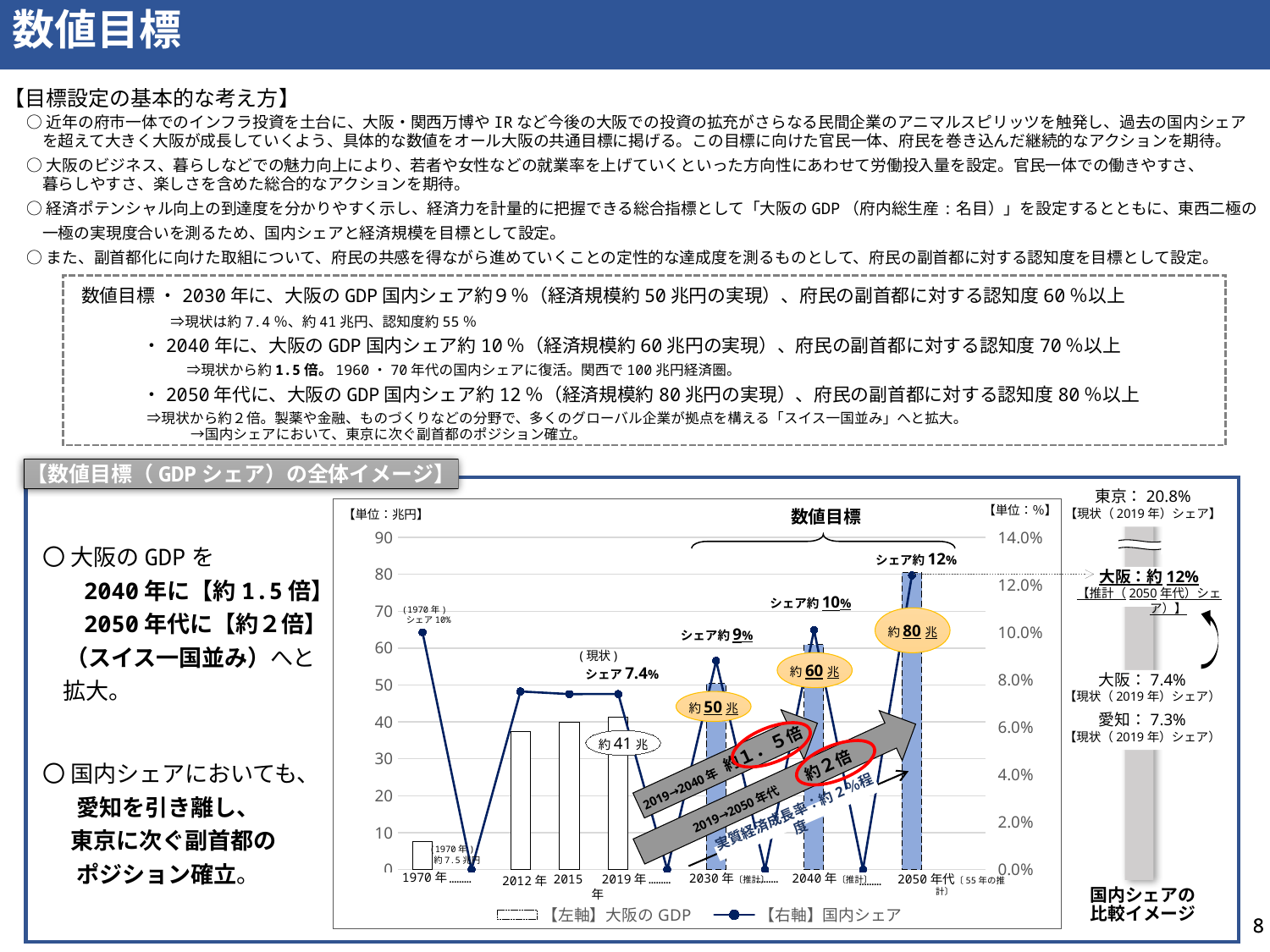
In the chart, which year has the tallest 大阪のGDP bar? 2050年代 In the chart, what is the labelled value of 大阪のGDP for 2050年代? 約80兆 In the chart, is the 大阪のGDP bar for 2012年 greater or less than 30 兆円? greater In the chart, what is the labelled 国内シェア for 2040年? シェア約10% What kind of chart is shown (bars plus line)? Combined bar and line chart How many year categories are shown on the x axis of the chart? 7 How many series does the chart legend list? 2 In the chart, which year has the shortest 大阪のGDP bar? 1970年 In the chart, which has the larger 大阪のGDP bar, 2030年 or 2040年? 2040年 In the chart, does the 国内シェア line rise or fall from 2019年 to 2050年代? rises In the chart, what 国内シェア is labelled for 1970年? 10% In the chart, what is the labelled 大阪のGDP for 2019年 (現状)? 約41兆